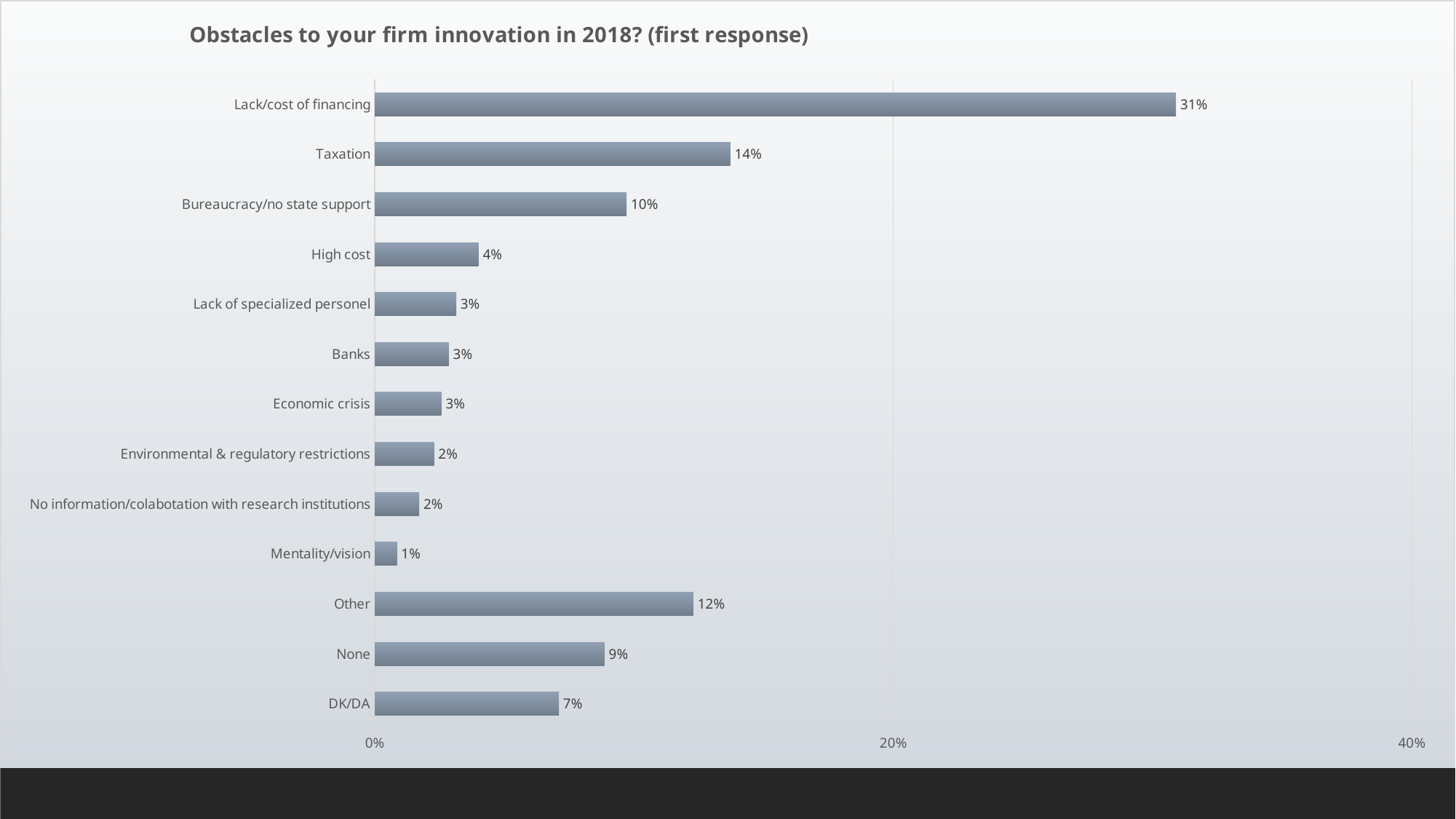
What is the value for Bureaucracy/no state support? 10% What is the difference between the values for Lack/cost of financing and Taxation? 17% Which category has the lowest value? Mentality/vision What is the value for Taxation? 14% What is the value for DK/DA? 7% Is the value for Lack/cost of financing greater or less than 20%? greater Which is larger, the value for Other or the value for None? Other Which category has the highest value? Lack/cost of financing How many categories are shown in the chart? 13 What is the title of the chart? Obstacles to your firm innovation in 2018? (first response) What kind of chart is shown on the slide? Bar chart What is the value for Lack/cost of financing? 31%